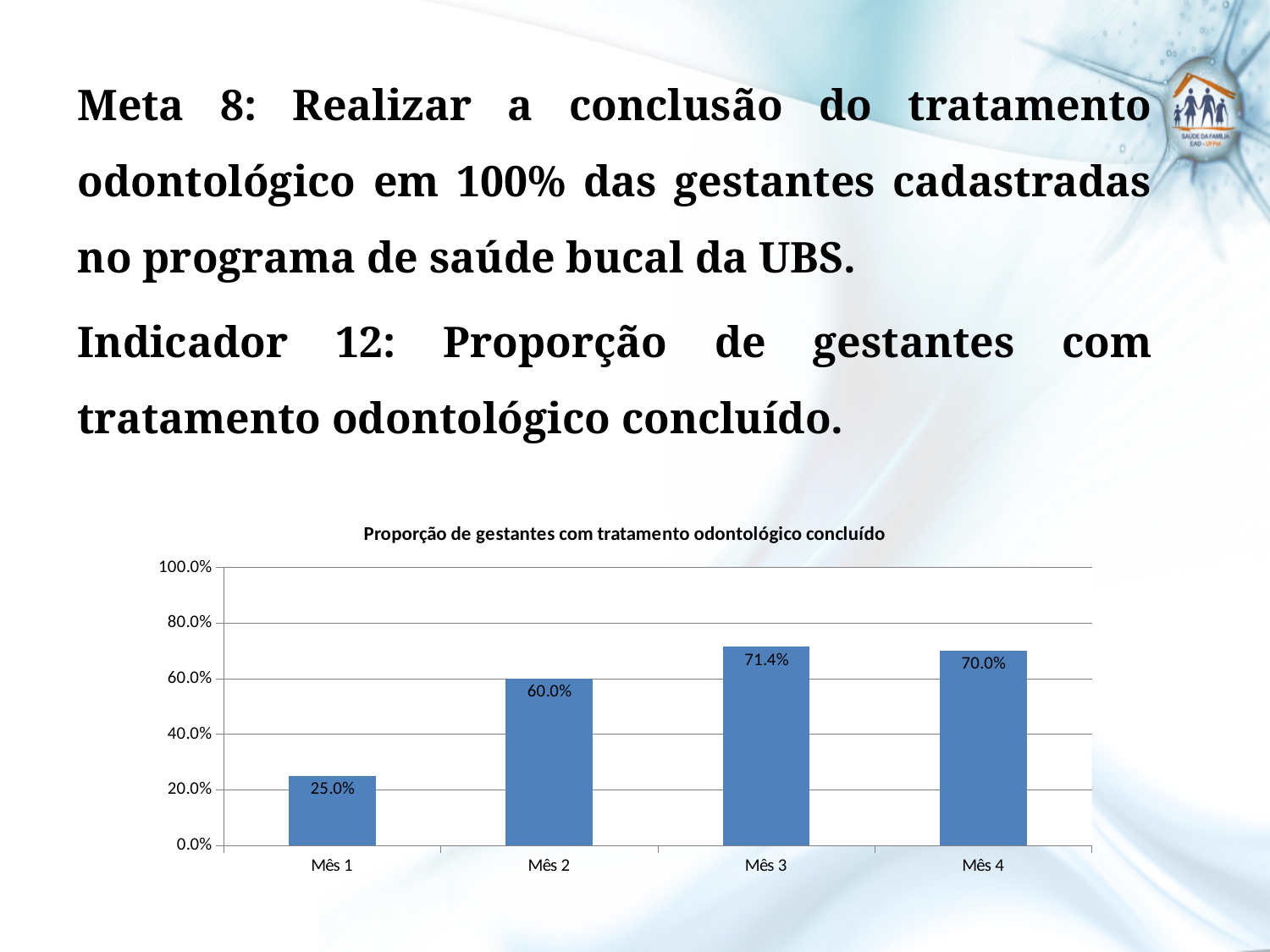
What kind of chart is shown on the slide? bar chart Which month has the highest value? Mês 3 What is the title of the chart? Proporção de gestantes com tratamento odontológico concluído What is the difference between the values for Mês 2 and Mês 1? 35.0% What is the value for Mês 4? 70.0% Is the value for Mês 2 greater or less than 40.0%? greater What is the difference between the values for Mês 3 and Mês 4? 1.4% How many months are shown on the x axis? 4 What is the value for Mês 1? 25.0% Which month has the lowest value? Mês 1 Which is larger, the value for Mês 2 or the value for Mês 4? Mês 4 What is the value for Mês 3? 71.4%